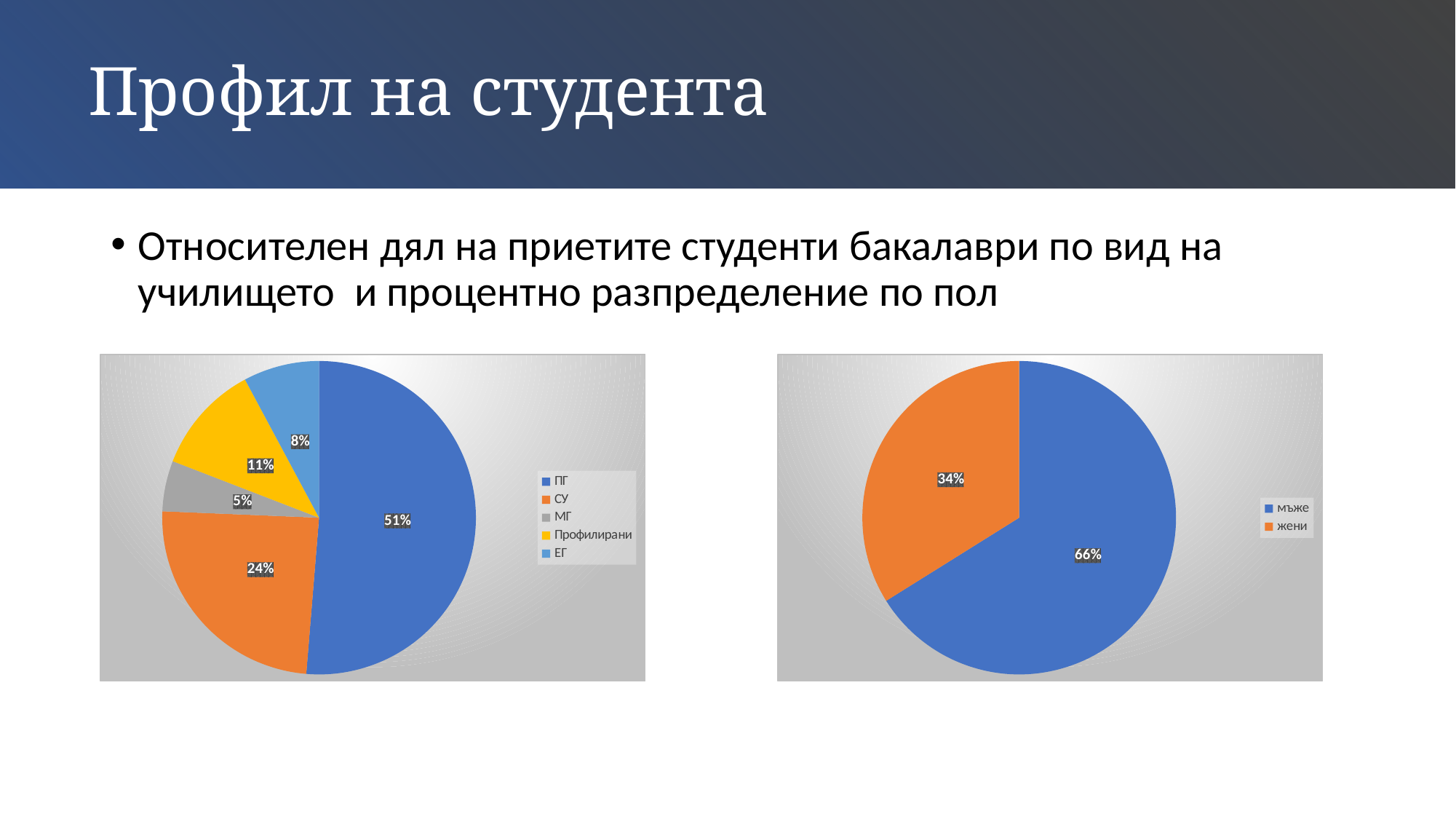
How many categories does the legend of the left pie chart list? 5 In the left pie chart, what is the difference between the shares of ПГ and СУ? 27 percentage points In the left pie chart, what share does Профилирани have? 11% What type of chart is the right chart? Pie chart In the right pie chart, what share do жени have? 34% In the left pie chart, which category has the smallest share? МГ In the right pie chart, what is the difference between the shares of мъже and жени? 32 percentage points In the left pie chart, which category has the largest share? ПГ In the left pie chart, which is larger, the share of ЕГ or the share of Профилирани? Профилирани In the right pie chart, what share do мъже have? 66% In the left pie chart, what share does ПГ have? 51% In the left pie chart, what share does СУ have? 24%